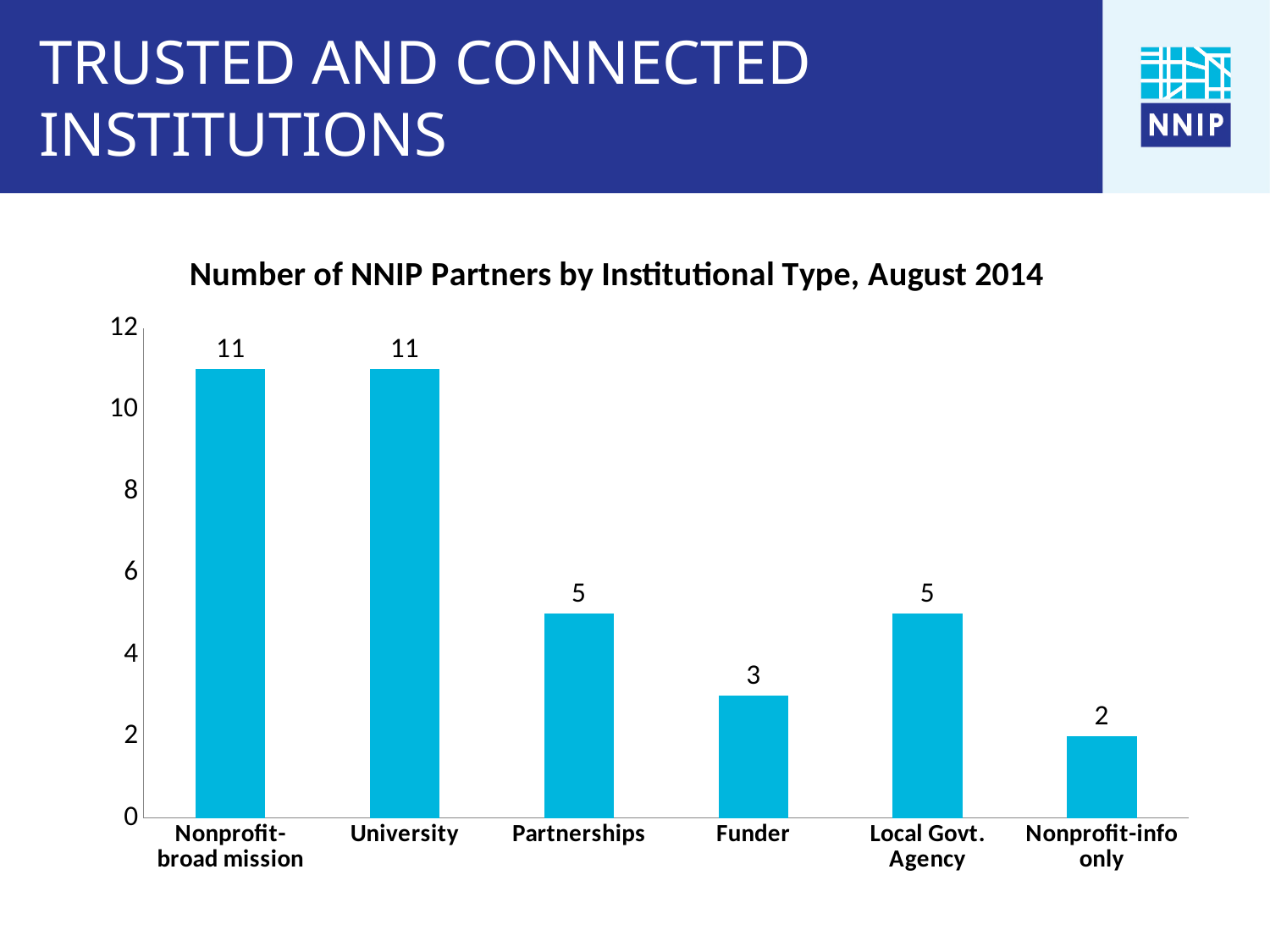
What is the number of NNIP partners for Nonprofit-info only? 2 Which has more NNIP partners, Partnerships or Funder? Partnerships What is the title of the chart? Number of NNIP Partners by Institutional Type, August 2014 Which institutional type has the lowest number of NNIP partners? Nonprofit-info only What is the difference between the number of partners for Funder and Nonprofit-info only? 1 What is the number of NNIP partners for Funder? 3 What kind of chart is shown on the slide? Bar chart What is the number of NNIP partners for Local Govt. Agency? 5 What is the difference between the number of partners for Nonprofit-broad mission and Partnerships? 6 Is the value for University greater or less than 10? greater How many institutional types are shown on the chart? 6 What is the number of NNIP partners for University? 11